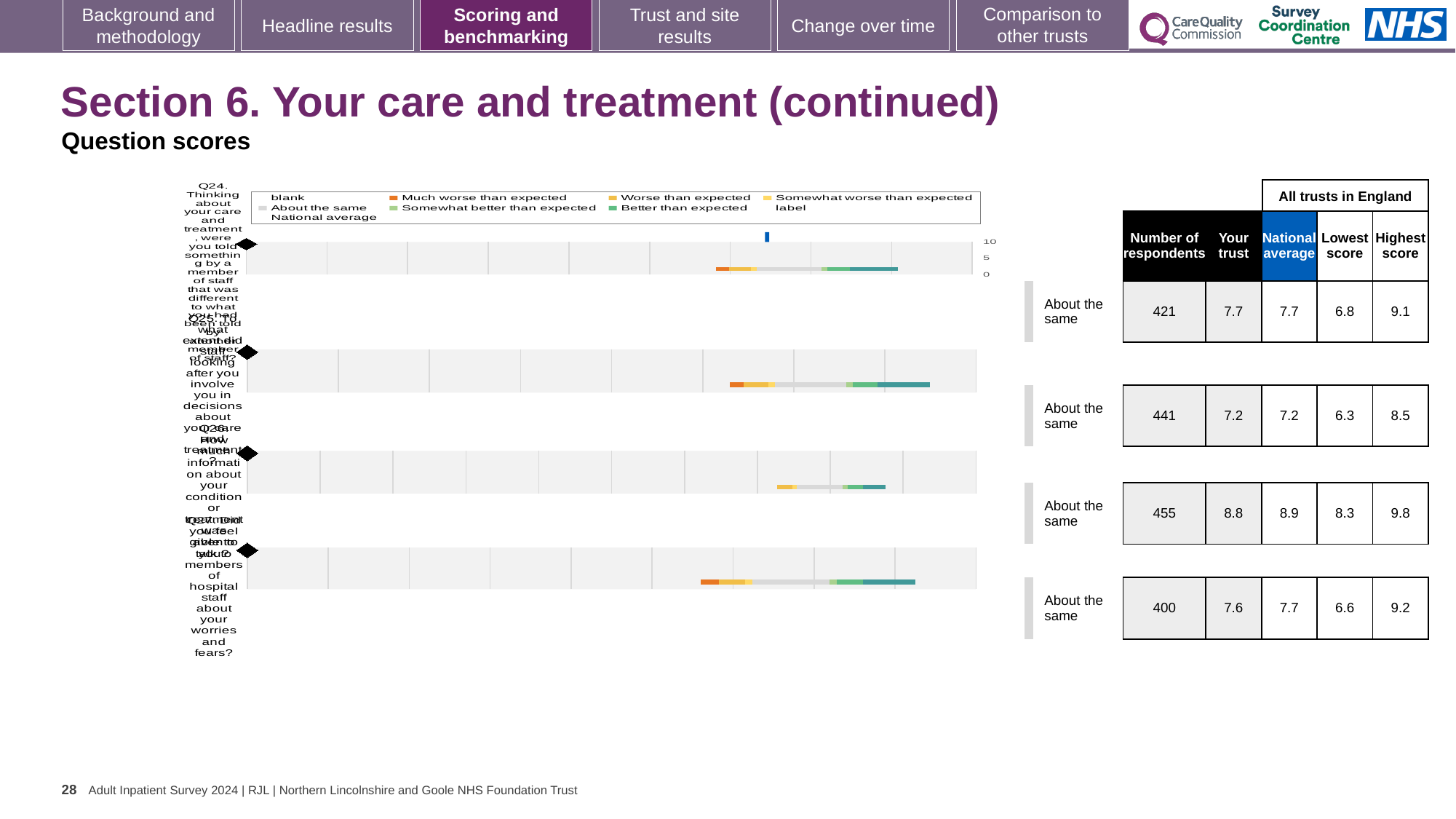
What colour does the legend use for 'Much worse than expected'? Orange For the second chart (Q25), what is the 'Your trust' score shown in the table? 7.2 Which chart's row has the highest 'Your trust' score? The third chart (Q26), 8.8 How many entries does the legend above the charts list? 9 For the top chart (Q24), what is the difference between the highest score and the lowest score? 2.3 How many benchmarking bar charts are shown on the slide? 4 Which chart's row has the lowest number of respondents? The bottom chart (Q27), 400 For the top chart (Q24), what is the number of respondents shown in the table? 421 What kind of chart is used for the benchmarking rows on this slide? Bar chart For the third chart (Q26), what is the highest score across all trusts in England? 9.8 What benchmark category label is shown beside each of the four charts? About the same For the bottom chart (Q27), what is the national average score? 7.7